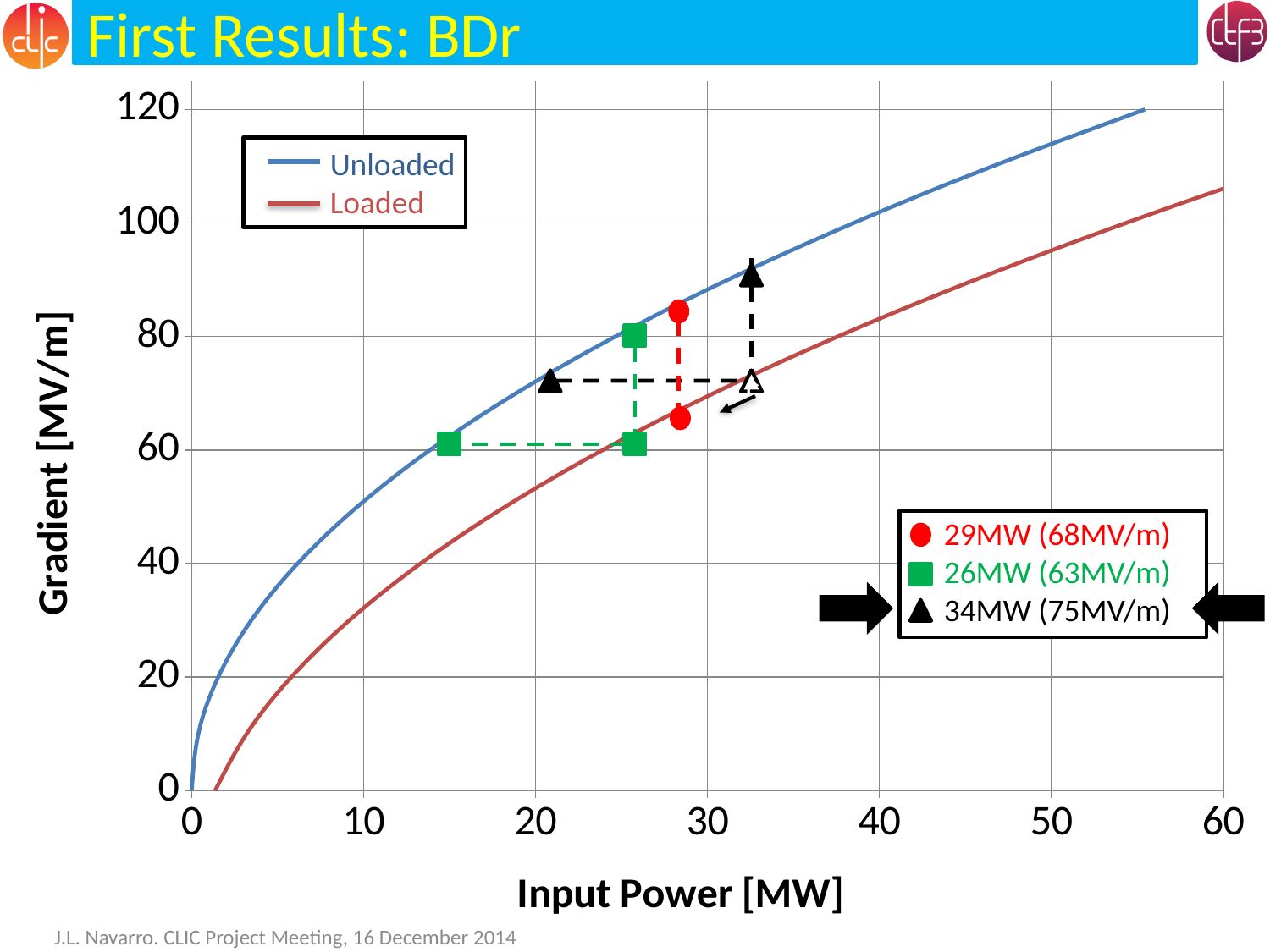
Is the Loaded curve's gradient at 50 MW input power greater or less than 100? less What gradient is given in the annotation box for the 34MW point? 75MV/m Does the gradient rise or fall as input power increases? rises Which curve lies higher at any given input power, Unloaded or Loaded? Unloaded What kind of chart is shown on the slide? line chart What is the difference in gradient between the 34MW point and the 26MW point in the annotation box? 12MV/m What is the label of the x axis? Input Power [MW] How many series does the chart legend list? 2 What gradient is given in the annotation box for the 29MW point? 68MV/m What gradient is given in the annotation box for the 26MW point? 63MV/m Which two series are listed in the chart legend? Unloaded and Loaded Of the three annotated operating points, which input power has the highest gradient? 34MW